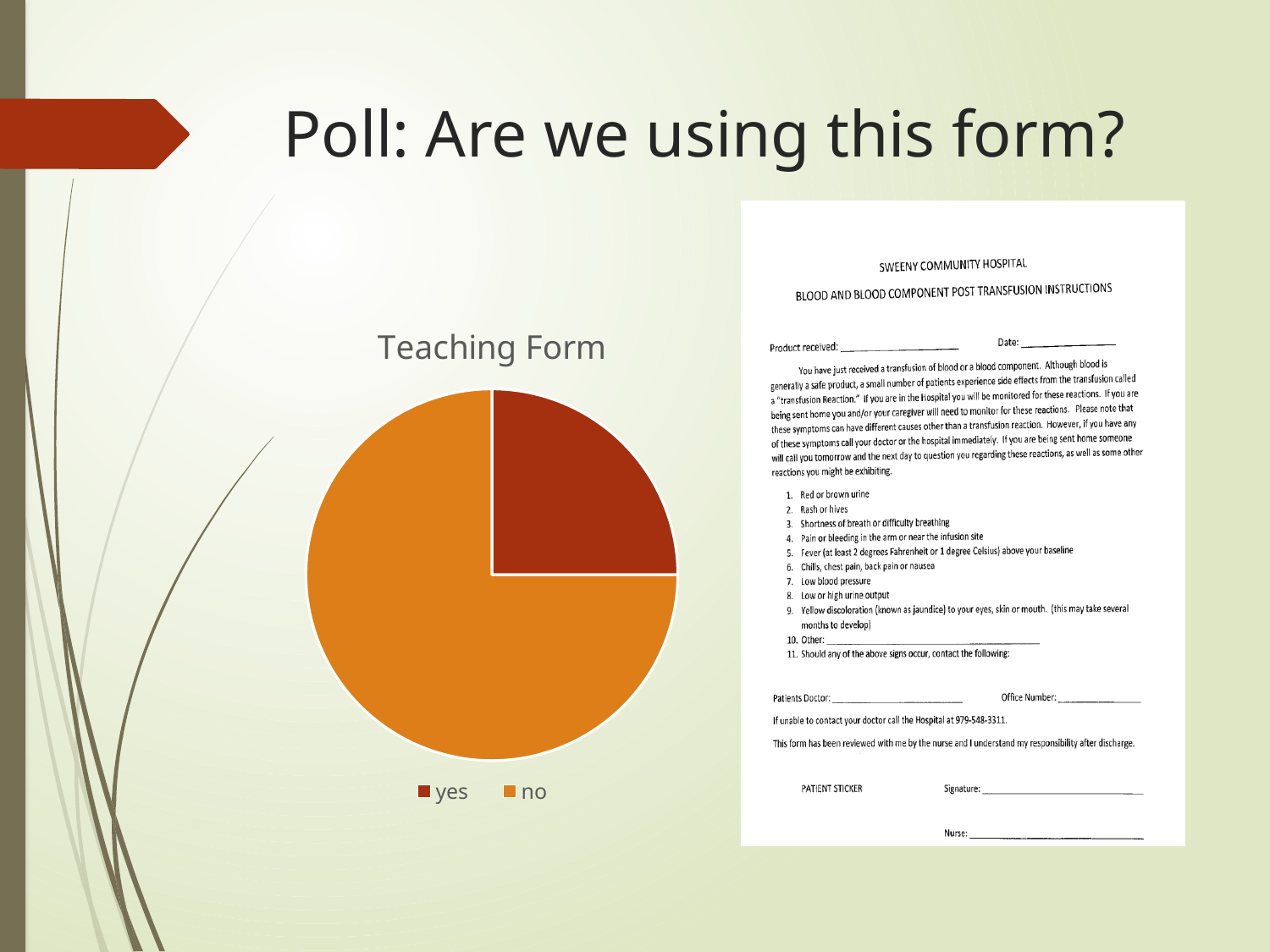
How many slices does the pie chart have? 2 Which category has the largest slice in the pie chart? no Does the 'no' slice take up more or less than half of the pie chart? more In the pie chart, which slice is larger, yes or no? no What colour is the 'no' slice in the pie chart? orange What is the title of the pie chart? Teaching Form Which category has the smallest slice in the pie chart? yes What kind of chart is shown on the slide? pie chart How many entries does the legend of the pie chart list? 2